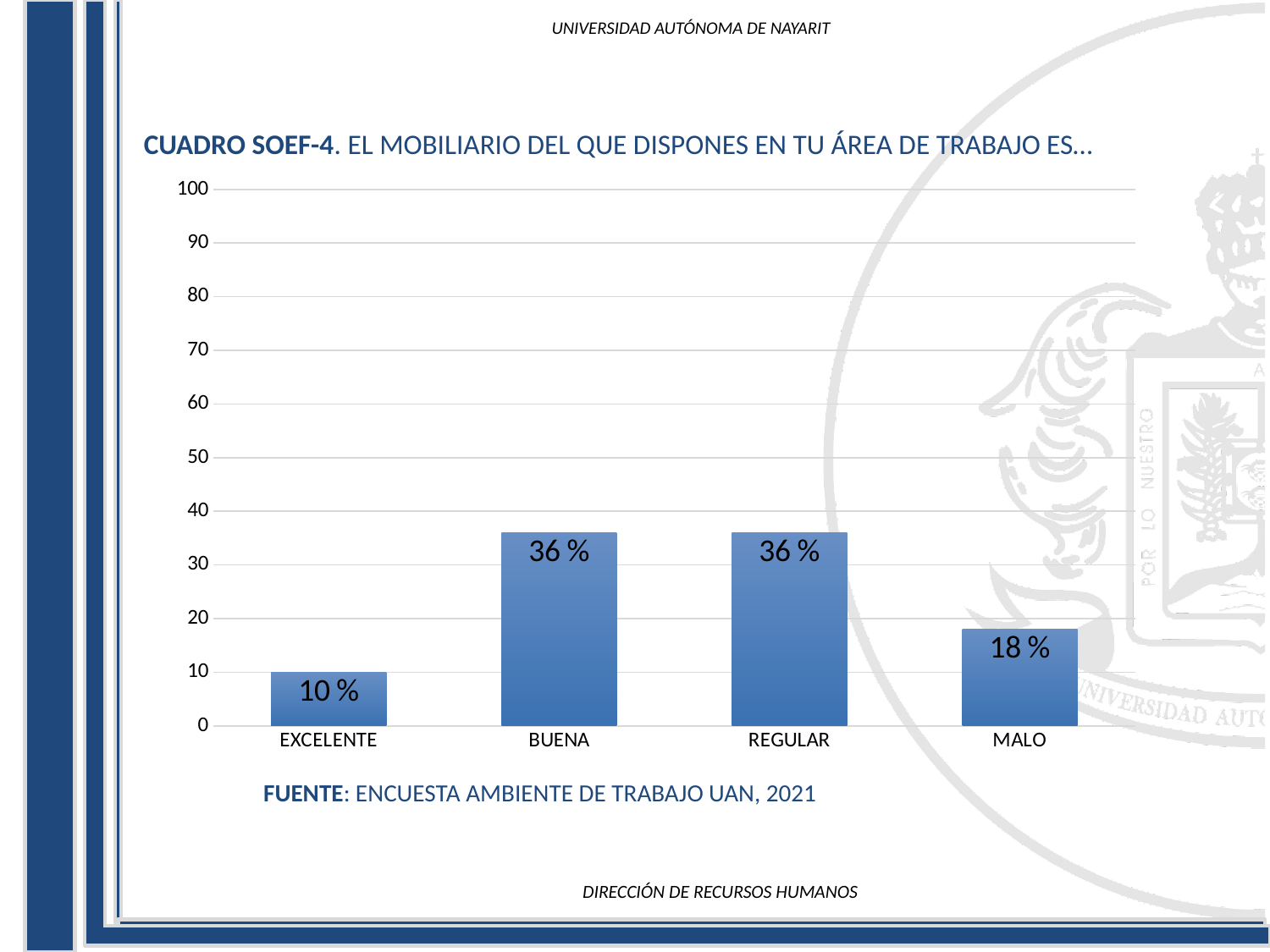
What kind of chart is shown on the slide? bar chart What source is cited below the chart? ENCUESTA AMBIENTE DE TRABAJO UAN, 2021 What is the difference between the values for REGULAR and MALO? 18 % Which is larger, the value for MALO or the value for EXCELENTE? MALO What is the value for BUENA? 36 % What is the difference between the values for MALO and EXCELENTE? 8 % What is the value for MALO? 18 % How many categories are shown on the x axis? 4 Is the value for BUENA greater or less than 30? greater What is the maximum value shown on the vertical axis? 100 What is the value for EXCELENTE? 10 % Which category has the lowest value? EXCELENTE